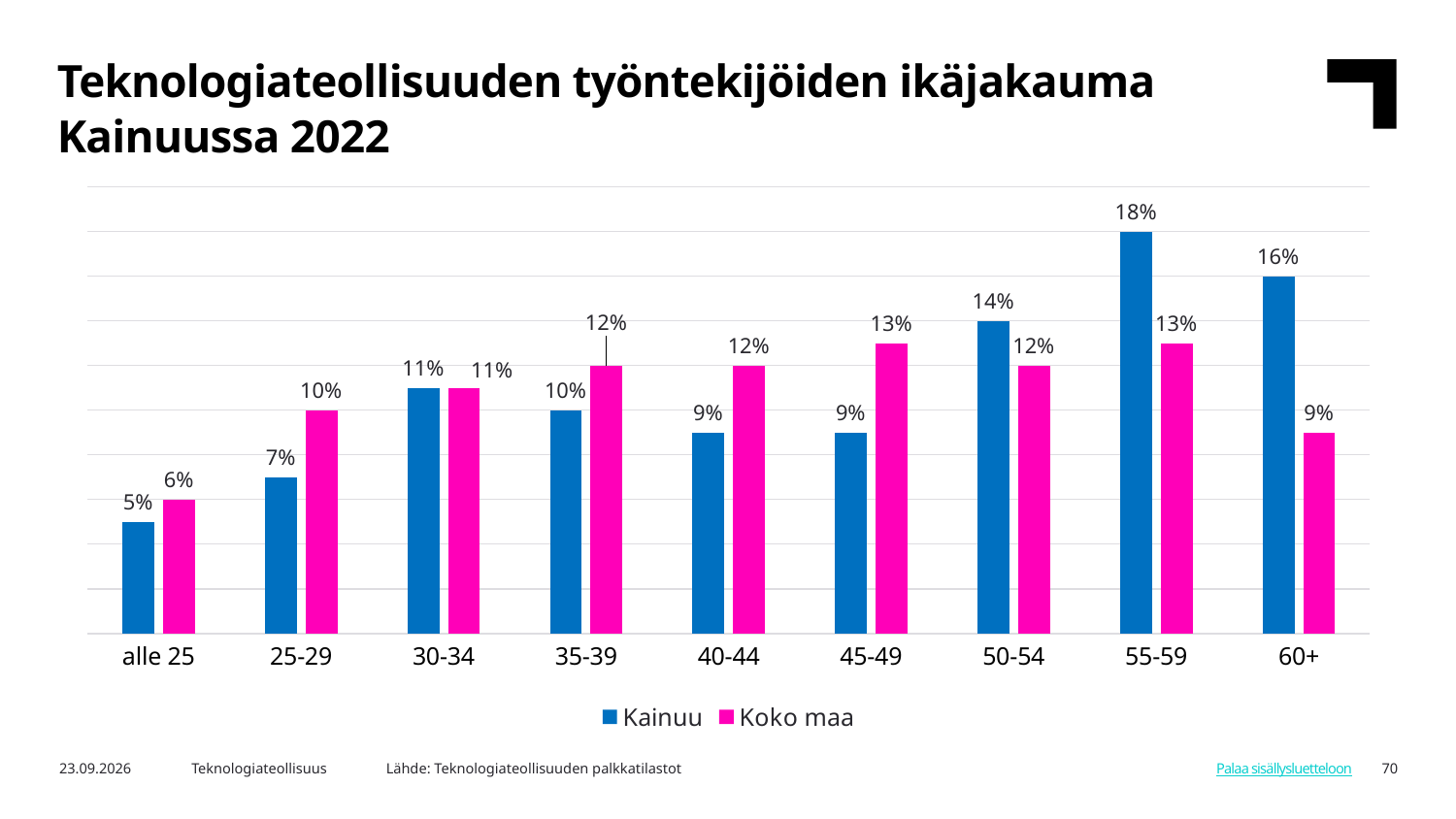
Which series is shown in pink? Koko maa What is the value for Kainuu in the 55-59 age group? 18% What kind of chart is shown on the slide? Bar chart Which age group has the lowest value for Koko maa? alle 25 What is the value for Kainuu in the alle 25 age group? 5% Which is larger in the 25-29 age group, Kainuu or Koko maa? Koko maa Which is larger in the 50-54 age group, Kainuu or Koko maa? Kainuu What is the difference between Kainuu and Koko maa in the 60+ age group? 7 percentage points How many age groups are shown on the x axis? 9 How many series does the legend list? 2 Which age group has the highest value for Kainuu? 55-59 What is the value for Koko maa in the 45-49 age group? 13%